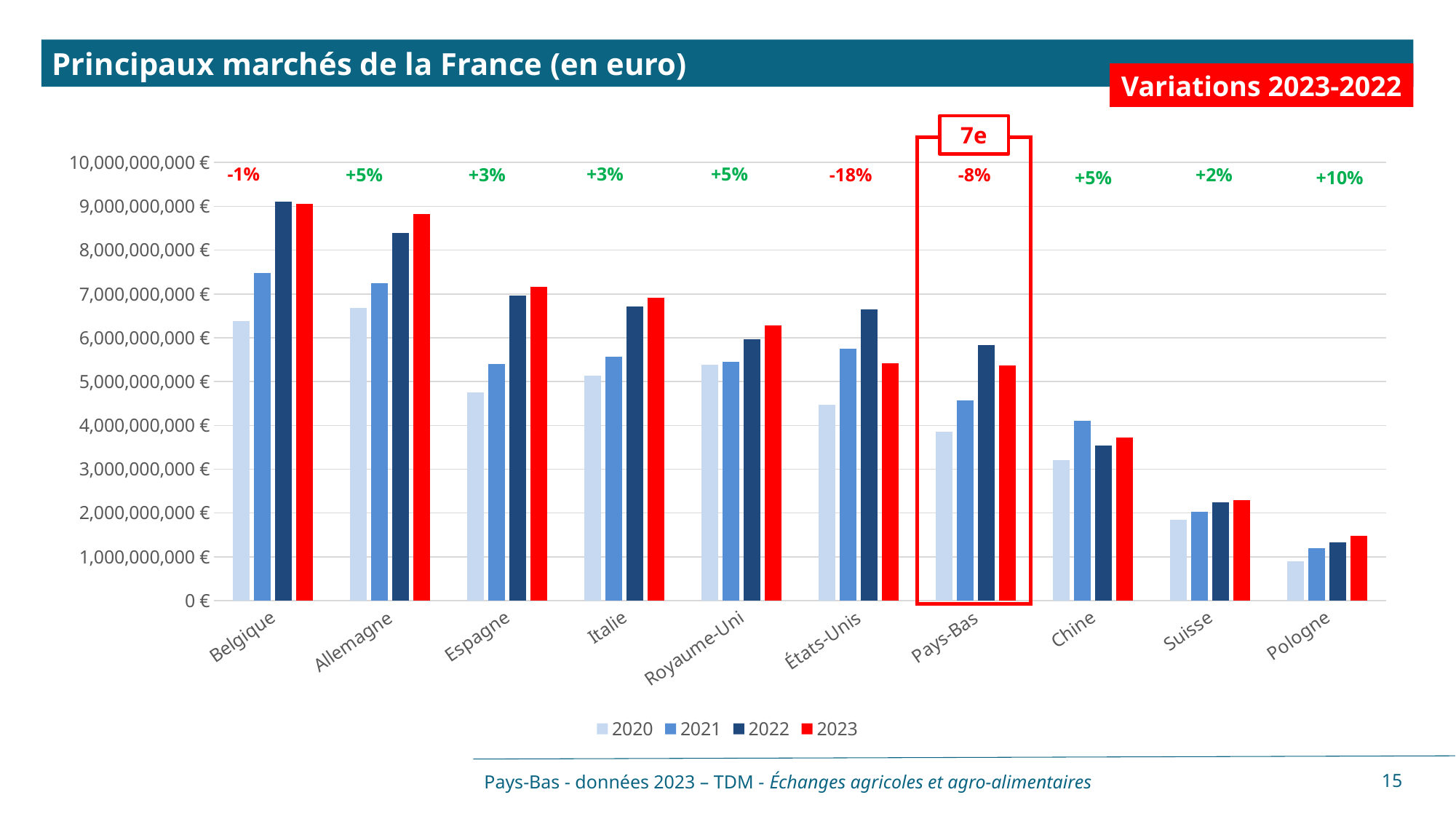
How many series does the legend list? 4 What is the 2023-2022 variation shown for États-Unis? -18% What kind of chart is shown on the slide? Bar chart Which country is highlighted with the red box labelled "7e"? Pays-Bas For Pologne, do the values rise or fall from 2020 to 2023? rise How many countries are shown on the x axis of the chart? 10 What is the 2023-2022 variation shown for Pays-Bas? -8% Is the 2023 value for Chine greater or less than 4,000,000,000 €? less Which country has the largest decrease in the 2023-2022 variation labels? États-Unis What is the 2023-2022 variation shown for Pologne? +10% Which country has the lowest 2023 value? Pologne Which is larger, the 2023 value for Italie or the 2023 value for Royaume-Uni? Italie